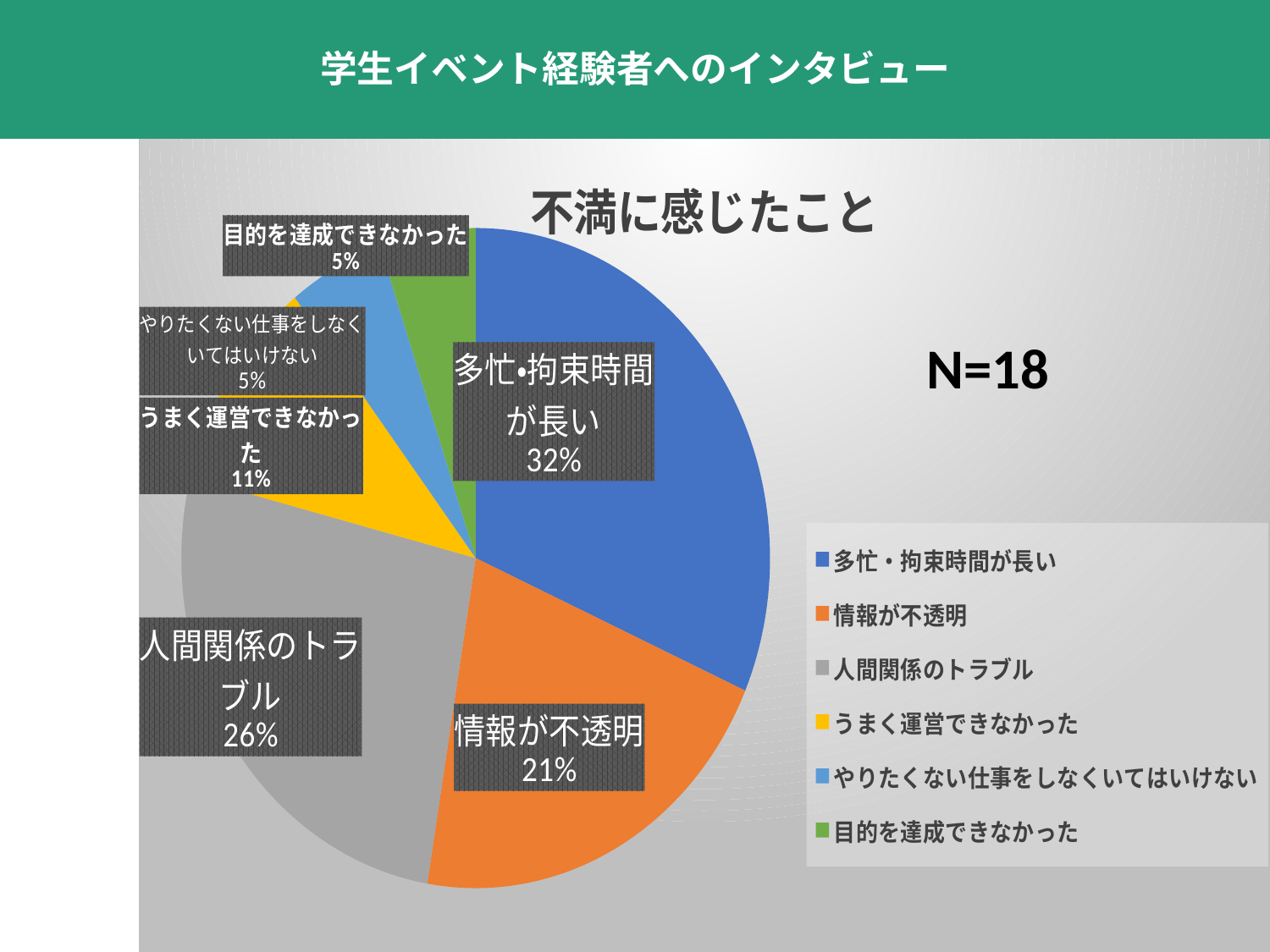
What is the value shown for うまく運営できなかった? 11% Which is larger, 人間関係のトラブル or 情報が不透明? 人間関係のトラブル What is the value shown for 人間関係のトラブル? 26% What is the value shown for 目的を達成できなかった? 5% What is the value shown for 情報が不透明? 21% What is the title of the pie chart? 不満に感じたこと Which category has the largest share of the pie? 多忙・拘束時間が長い What percentage of the pie is 多忙・拘束時間が長い? 32% What kind of chart is shown on the slide? pie chart What sample size (N) is stated on the slide? N=18 How many categories (slices) does the pie chart have? 6 What is the difference in percentage points between 多忙・拘束時間が長い and 情報が不透明? 11